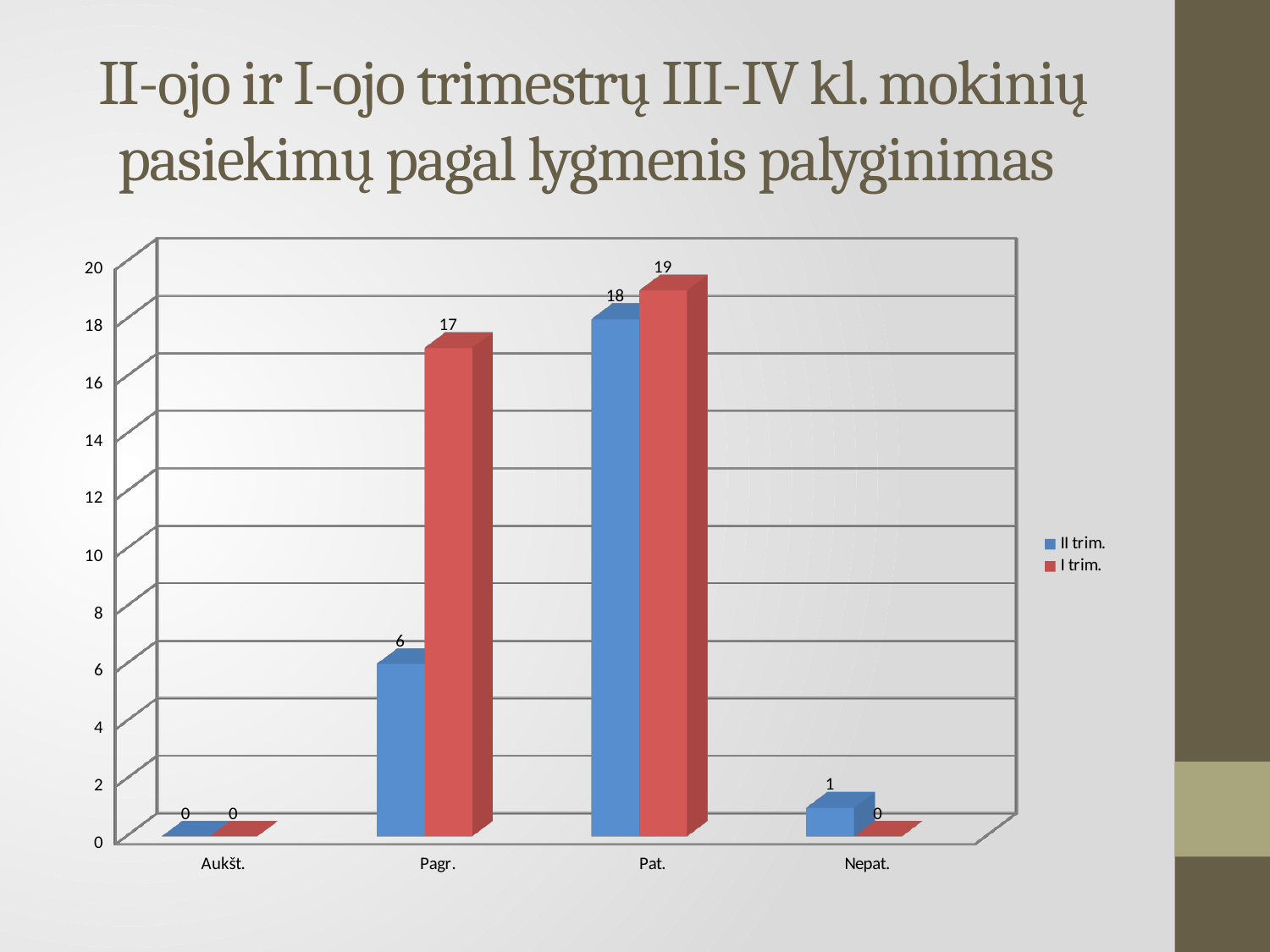
How many categories are shown on the x axis? 4 What is the difference between I trim. and II trim. in the Pagr. category? 11 What colour are the bars for the I trim. series? Red Which is larger in the Pagr. category, II trim. or I trim.? I trim. Which category has the highest value for I trim.? Pat. How many series does the legend list? 2 Which category has the highest value for II trim.? Pat. What is the value for I trim. in the Pat. category? 19 What is the value for II trim. in the Pagr. category? 6 What is the difference between I trim. and II trim. in the Pat. category? 1 What is the value for II trim. in the Nepat. category? 1 What kind of chart is shown on the slide? Bar chart